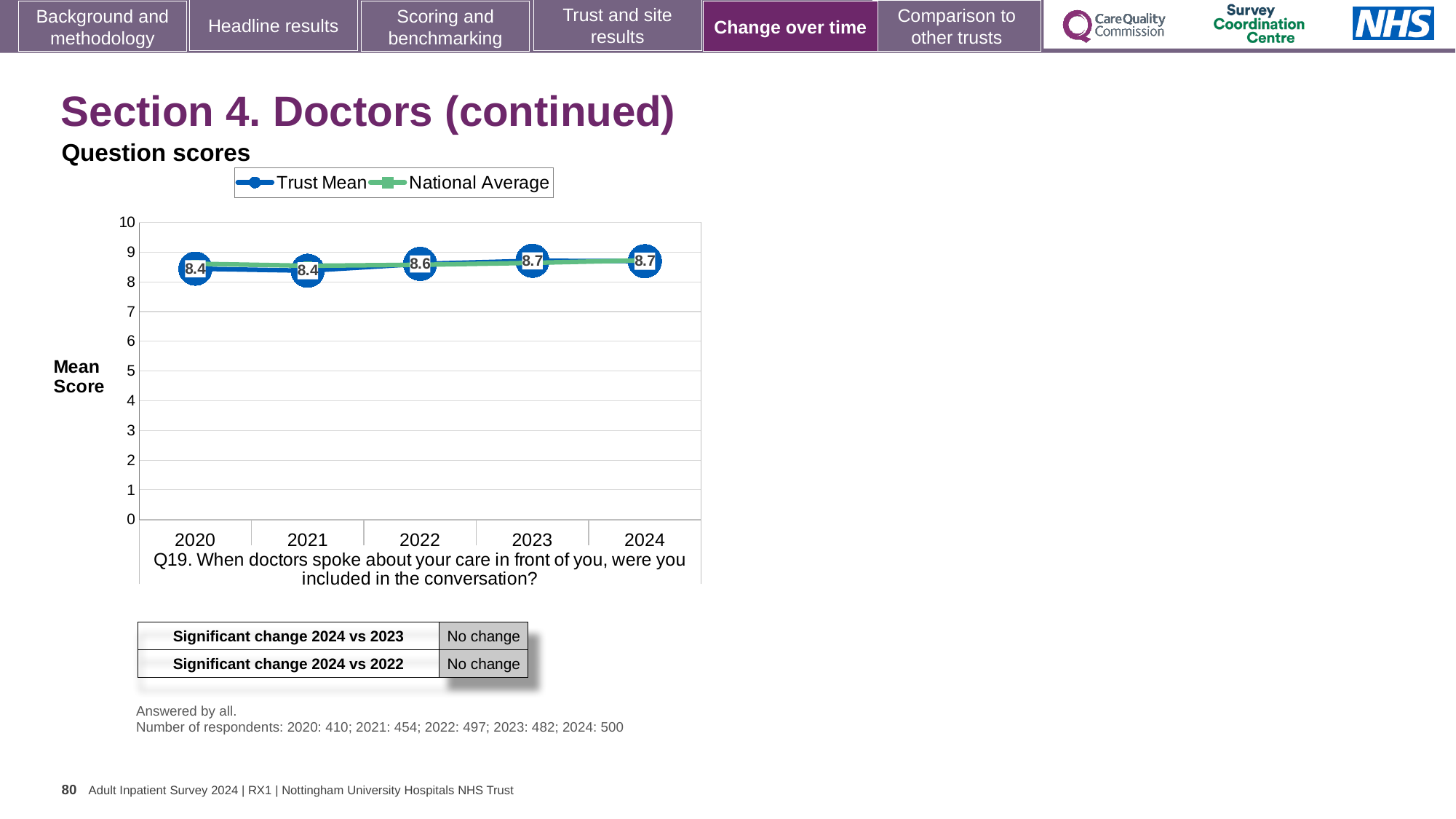
What is the difference between the Trust Mean score in 2024 and in 2020? 0.3 How many years are plotted on the x axis of the chart? 5 What is the Trust Mean score for 2024? 8.7 Which is larger, the Trust Mean score for 2022 or for 2021? 2022 What is the Trust Mean score for 2022? 8.6 What kind of chart is shown on the slide? Line chart What is the Trust Mean score for 2023? 8.7 Is the National Average value for 2020 greater or less than 8? greater How many series does the chart legend list? 2 What are the two series named in the chart legend? Trust Mean and National Average What is the Trust Mean score for 2020? 8.4 Does the Trust Mean score rise or fall from 2020 to 2024? Rise